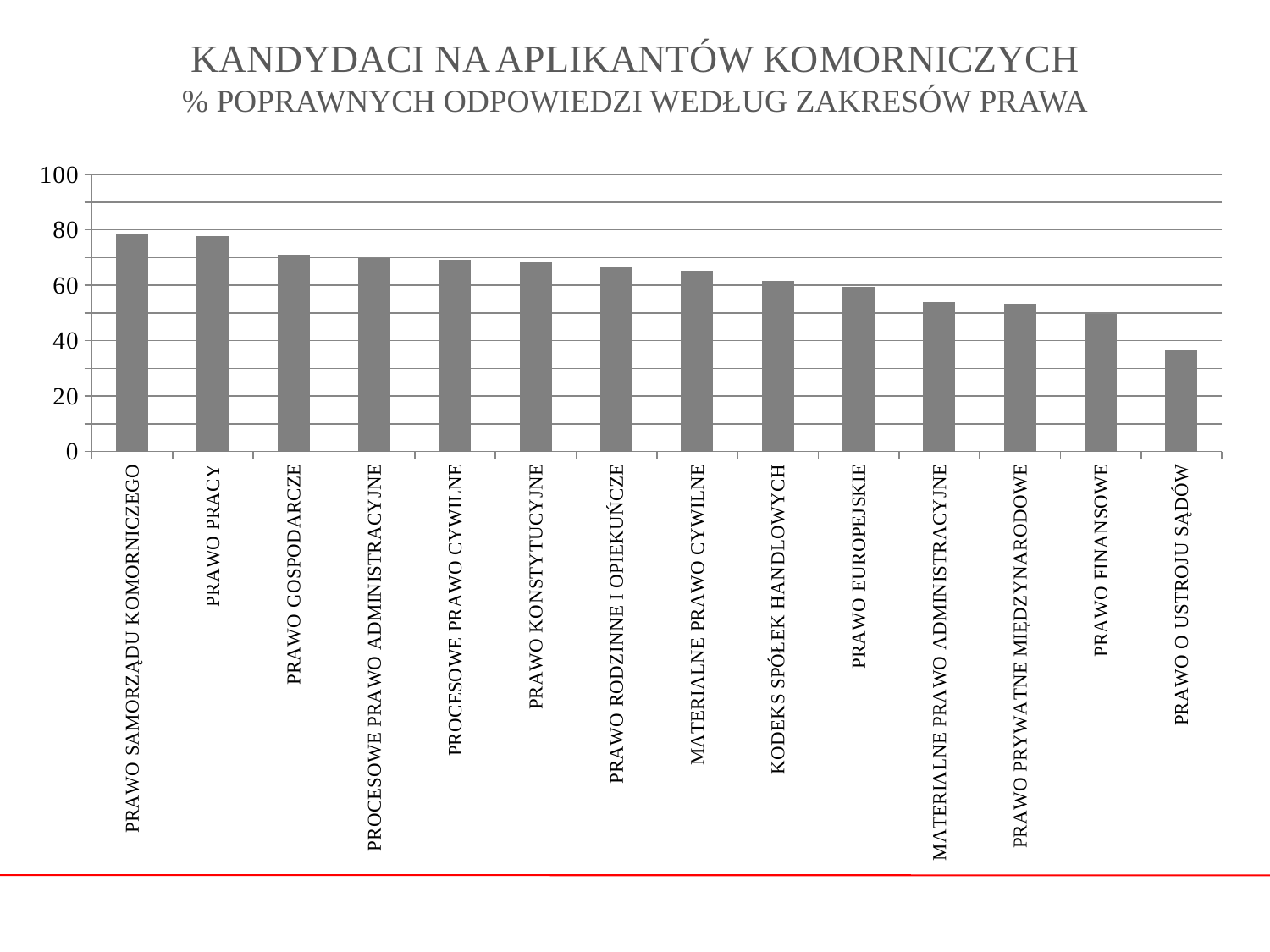
Is the value for PRAWO KONSTYTUCYJNE greater or less than 60? greater How many categories (areas of law) are plotted on the chart? 14 Is the value for PRAWO O USTROJU SĄDÓW greater or less than 40? less Is the value for PRAWO SAMORZĄDU KOMORNICZEGO greater or less than 80? less Which area of law has the lowest percentage of correct answers? PRAWO O USTROJU SĄDÓW What kind of chart is shown on the slide? bar chart What is the main title of the chart? KANDYDACI NA APLIKANTÓW KOMORNICZYCH Do the bar values rise or fall from left to right along the x axis? fall Which is larger, the value for PRAWO KONSTYTUCYJNE or the value for PRAWO EUROPEJSKIE? PRAWO KONSTYTUCYJNE Which is larger, the value for PRAWO PRACY or the value for PRAWO FINANSOWE? PRAWO PRACY